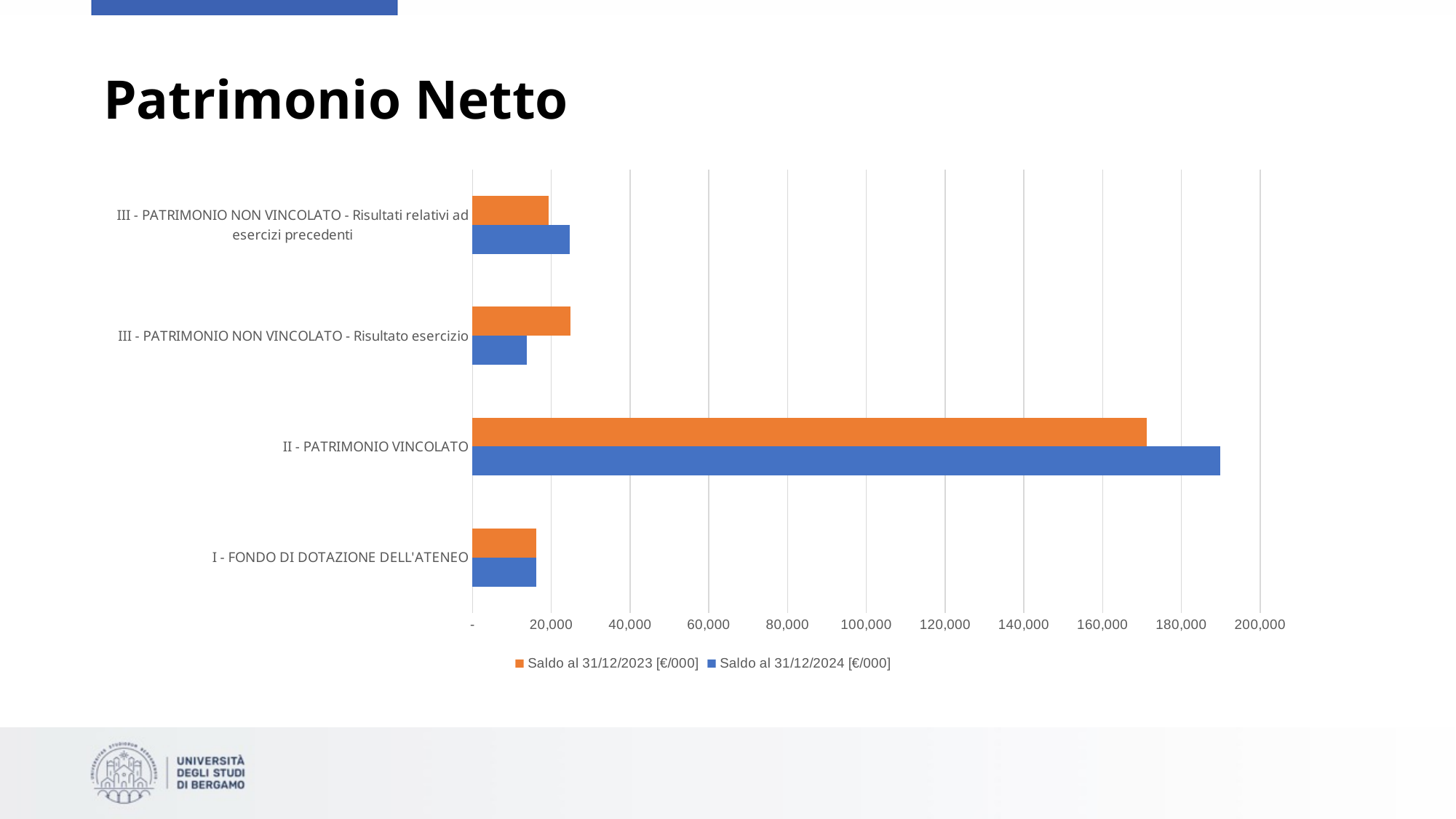
Which category has the highest value for Saldo al 31/12/2024 [€/000]? II - PATRIMONIO VINCOLATO Which series is shown in orange in the legend? Saldo al 31/12/2023 [€/000] How many series does the legend list? 2 For III - PATRIMONIO NON VINCOLATO - Risultati relativi ad esercizi precedenti, which series has the larger value: Saldo al 31/12/2023 [€/000] or Saldo al 31/12/2024 [€/000]? Saldo al 31/12/2024 [€/000] Is the value for II - PATRIMONIO VINCOLATO in Saldo al 31/12/2024 [€/000] greater or less than 180,000? greater Which category has the highest value for Saldo al 31/12/2023 [€/000]? II - PATRIMONIO VINCOLATO What kind of chart is shown on the slide? Bar chart How many categories are plotted on the chart? 4 Is the value for II - PATRIMONIO VINCOLATO in Saldo al 31/12/2023 [€/000] greater or less than 180,000? less What is the title of the slide containing the chart? Patrimonio Netto For III - PATRIMONIO NON VINCOLATO - Risultato esercizio, which series has the larger value: Saldo al 31/12/2023 [€/000] or Saldo al 31/12/2024 [€/000]? Saldo al 31/12/2023 [€/000] Is the value for I - FONDO DI DOTAZIONE DELL'ATENEO in Saldo al 31/12/2023 [€/000] greater or less than 20,000? less